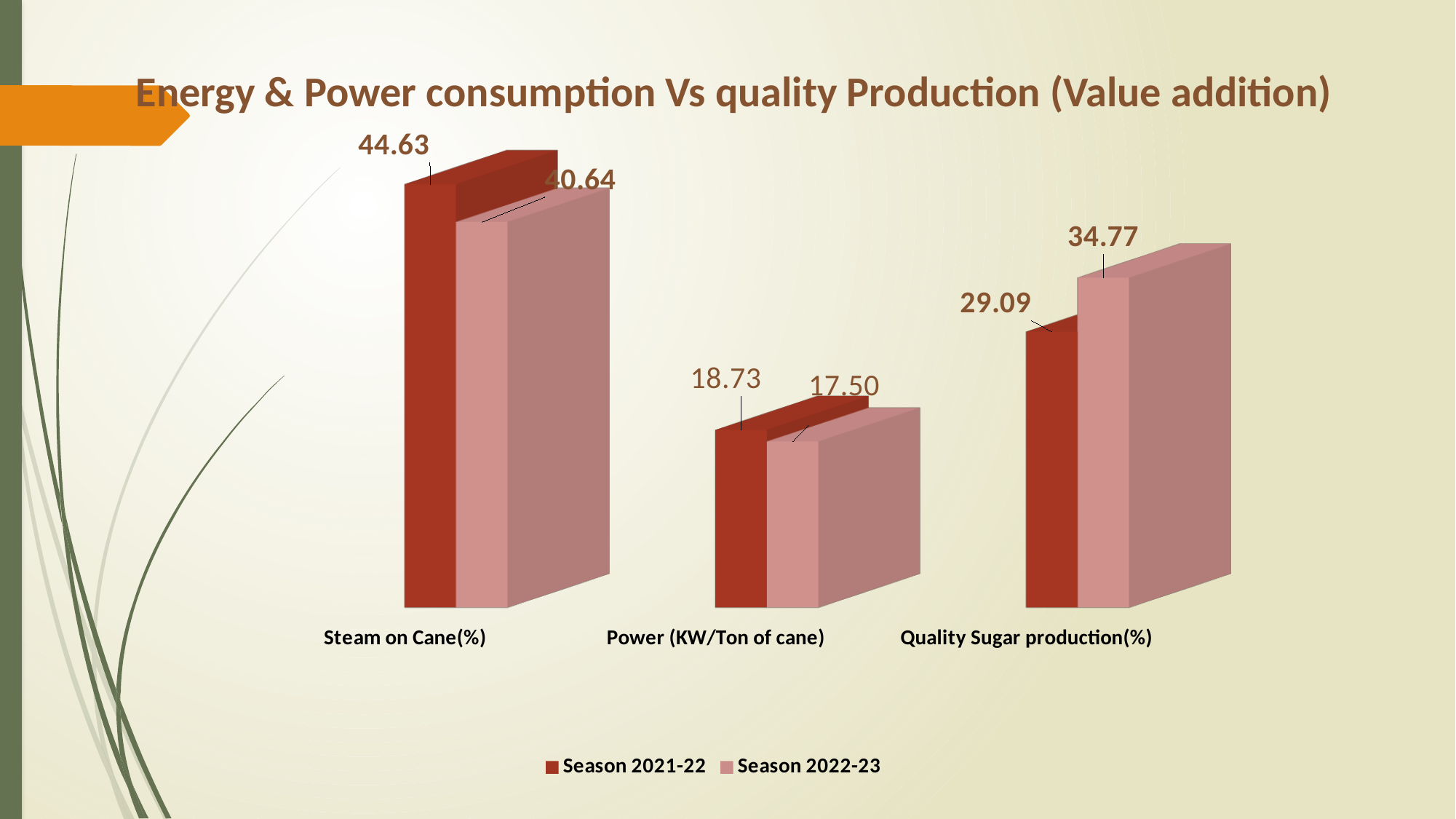
What kind of chart is shown on the slide? Bar chart What is the value for Steam on Cane(%) in Season 2022-23? 40.64 What is the value for Steam on Cane(%) in Season 2021-22? 44.63 How many series does the legend list? 2 For Quality Sugar production(%), which season has the larger value, Season 2021-22 or Season 2022-23? Season 2022-23 How many categories are shown on the x axis? 3 What is the value for Power (KW/Ton of cane) in Season 2022-23? 17.50 What is the value for Power (KW/Ton of cane) in Season 2021-22? 18.73 Which category has the lowest value in Season 2022-23? Power (KW/Ton of cane) Which category has the highest value in Season 2021-22? Steam on Cane(%) What is the value for Quality Sugar production(%) in Season 2022-23? 34.77 What is the difference between the Season 2021-22 and Season 2022-23 values for Steam on Cane(%)? 3.99